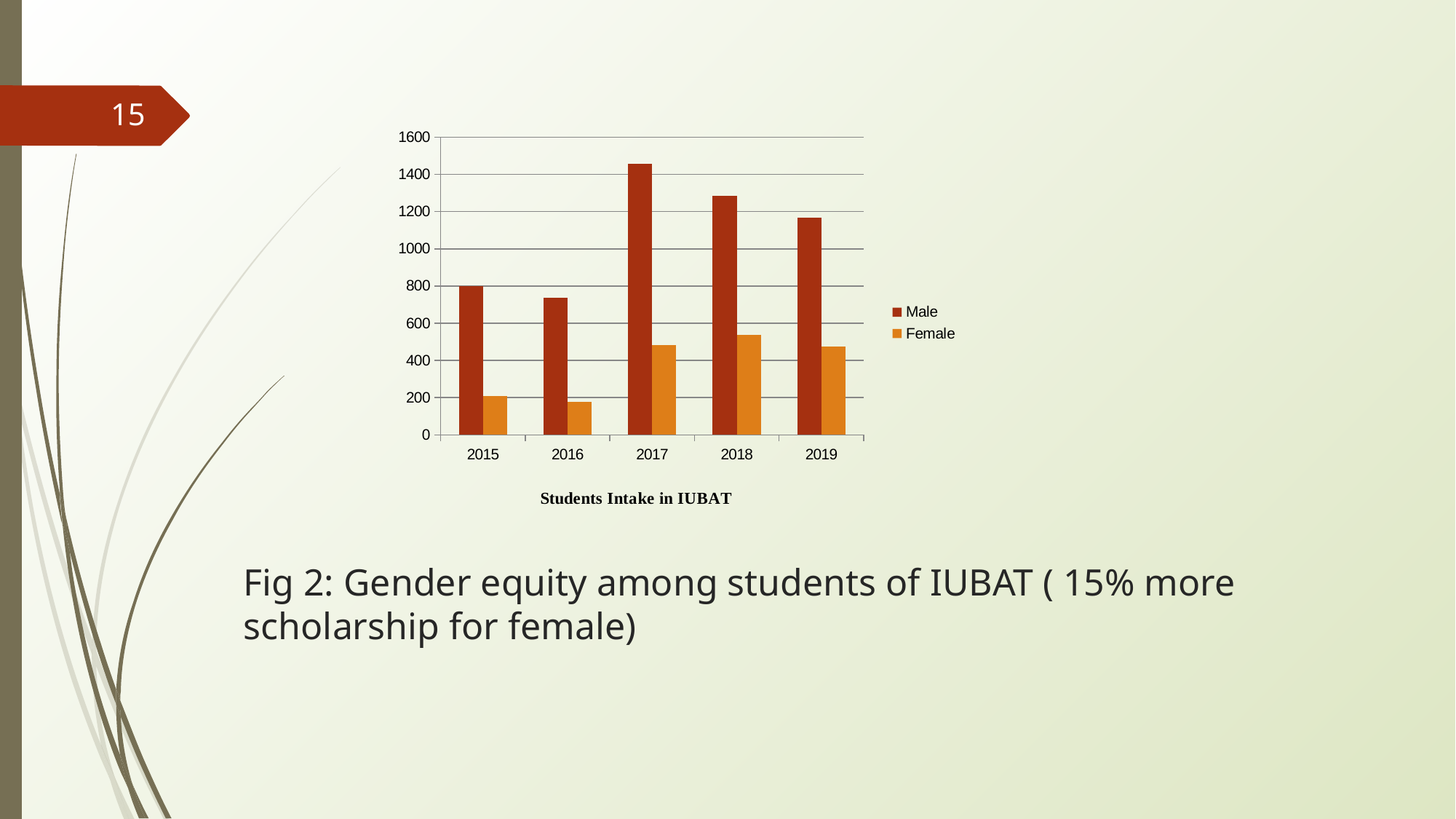
Does the Male intake rise or fall from 2017 to 2019? fall In which year is the Female intake lowest? 2016 How many series does the legend list? 2 What is the title of the chart? Students Intake in IUBAT Is the Female intake in 2015 greater or less than 400? less In which year is the Male intake highest? 2017 What kind of chart is shown on the slide? bar chart Which is larger, the Male intake in 2018 or the Male intake in 2019? Male intake in 2018 In which year is the Female intake highest? 2018 In which year is the Male intake lowest? 2016 Is the Male intake in 2017 greater or less than 1400? greater How many years are shown on the x axis? 5